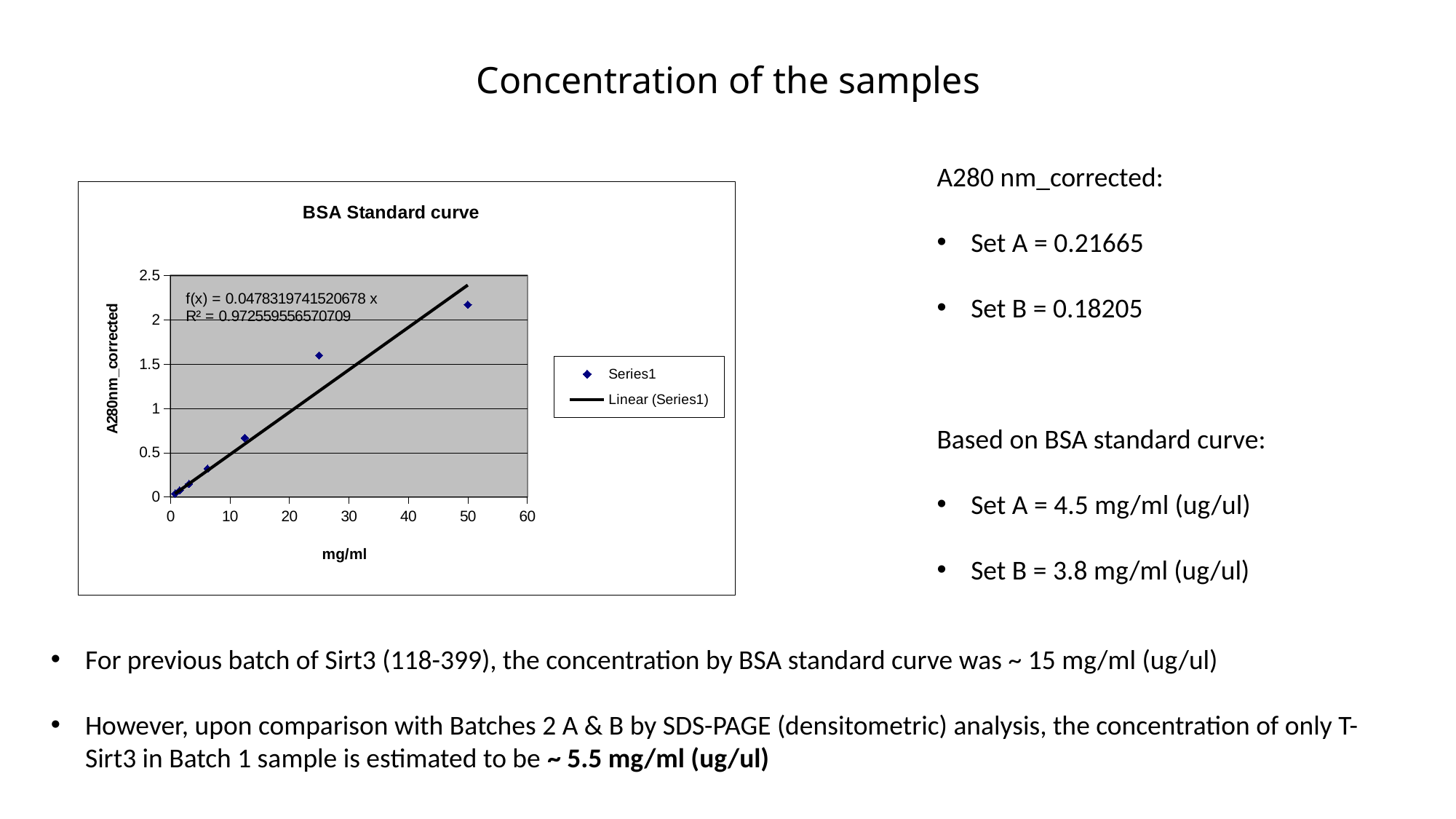
Is the A280nm_corrected value for the point at 12.5 mg/ml greater or less than 1? less What is the slope of the fitted line f(x) shown on the chart? 0.0478319741520678 Do the plotted values rise or fall as mg/ml increases along the x axis? rise What R² value is shown on the chart? 0.972559556570709 Is the A280nm_corrected value for the point at 12.5 mg/ml greater or less than 0.5? greater At which mg/ml value is the highest plotted A280nm_corrected point? 50 What is the label of the x axis of the chart? mg/ml How many entries does the chart legend list? 2 What kind of chart is the BSA Standard curve? scatter chart What is the title of the chart? BSA Standard curve Is the A280nm_corrected value for the point at 50 mg/ml greater or less than 2? greater